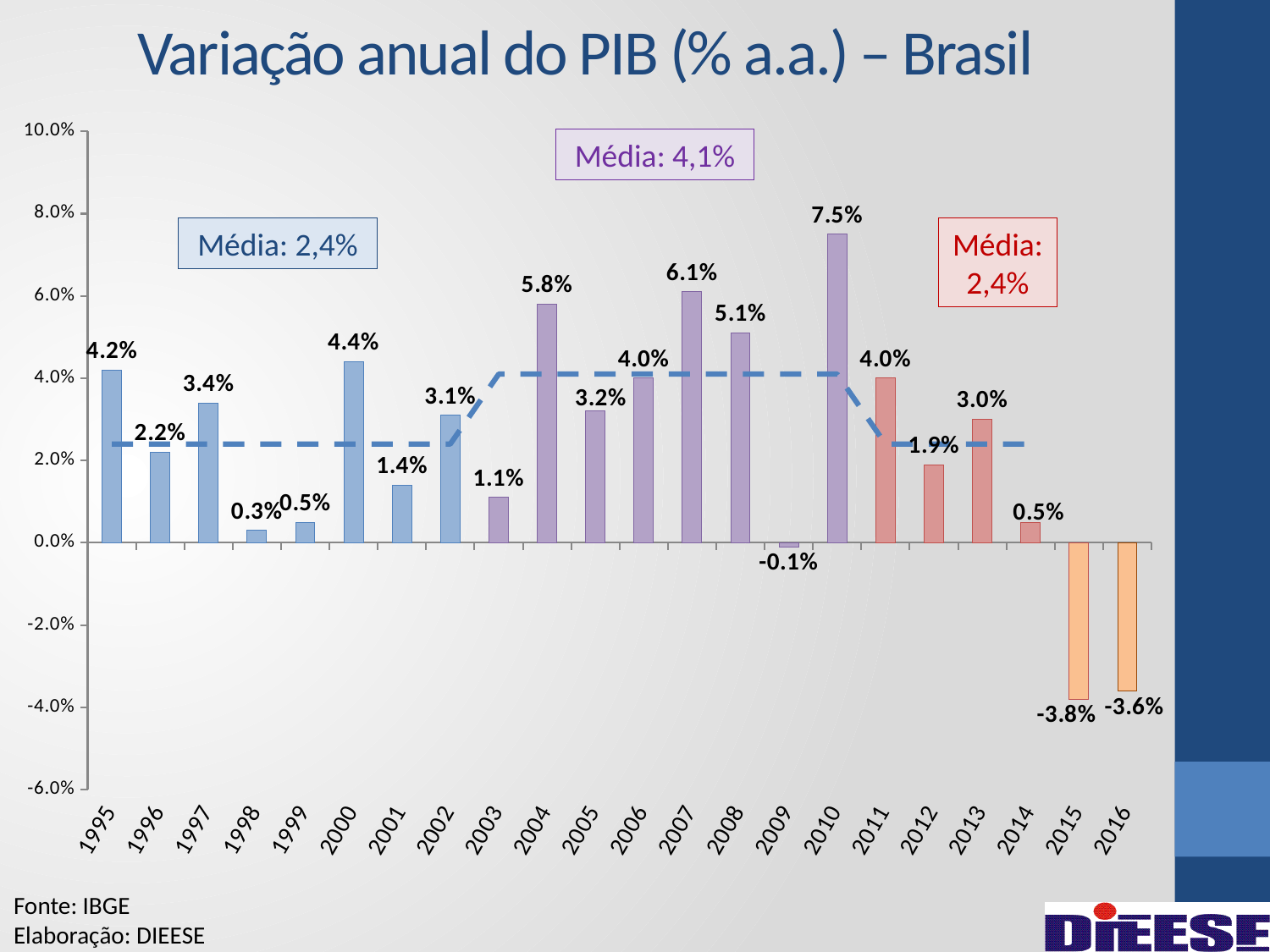
How many years are shown on the x axis? 22 What is the value for 2010? 7.5% What is the value for 2015? -3.8% Which year has the highest value? 2010 What is the value for 1998? 0.3% What is the value for 2009? -0.1% Do the values rise or fall from 2010 to 2012? Fall What is the title of the chart? Variação anual do PIB (% a.a.) – Brasil Which year has the lowest value? 2015 Which is larger, the value for 2004 or the value for 2007? 2007 What is the difference between the values for 2010 and 2009? 7.6 percentage points What kind of chart is this? Combination bar and line chart